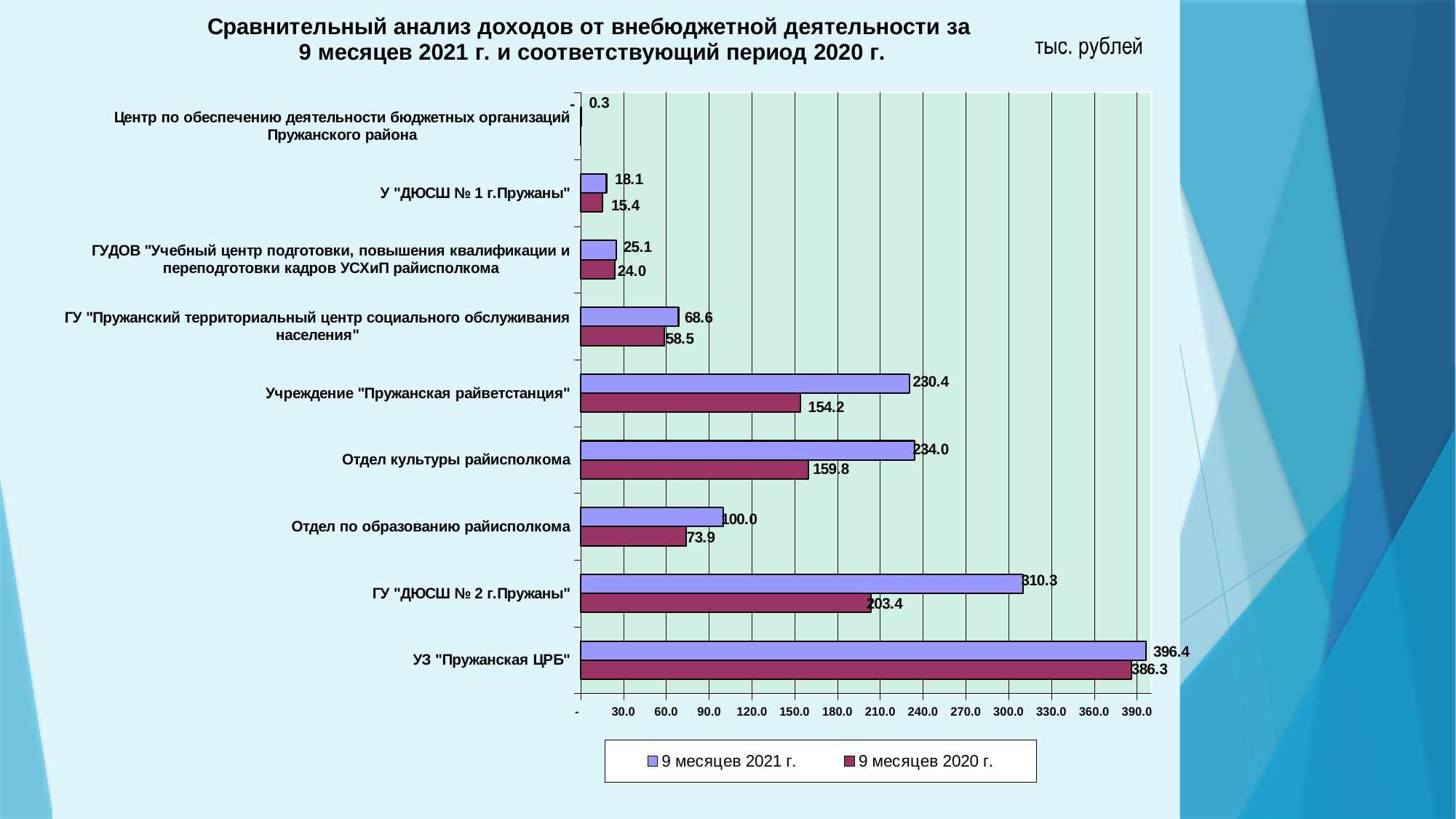
What is the value for ГУ "ДЮСШ № 2 г.Пружаны" for 9 месяцев 2020 г.? 203.4 What is the value for Отдел по образованию райисполкома for 9 месяцев 2021 г.? 100.0 Which organization has the lowest value for 9 месяцев 2020 г.? Центр по обеспечению деятельности бюджетных организаций Пружанского района How many organizations (categories) are shown on the chart? 9 For 9 месяцев 2021 г., which is larger: Отдел культуры райисполкома or Учреждение "Пружанская райветстанция"? Отдел культуры райисполкома What is the value for УЗ "Пружанская ЦРБ" for 9 месяцев 2021 г.? 396.4 How many series does the legend list? 2 Which organization has the highest value for 9 месяцев 2021 г.? УЗ "Пружанская ЦРБ" In what units are the values on the chart given? тыс. рублей What type of chart is shown on the slide? Bar chart What is the difference between the 2021 and 2020 values for ГУ "ДЮСШ № 2 г.Пружаны"? 106.9 What is the difference between the 2021 and 2020 values for Учреждение "Пружанская райветстанция"? 76.2